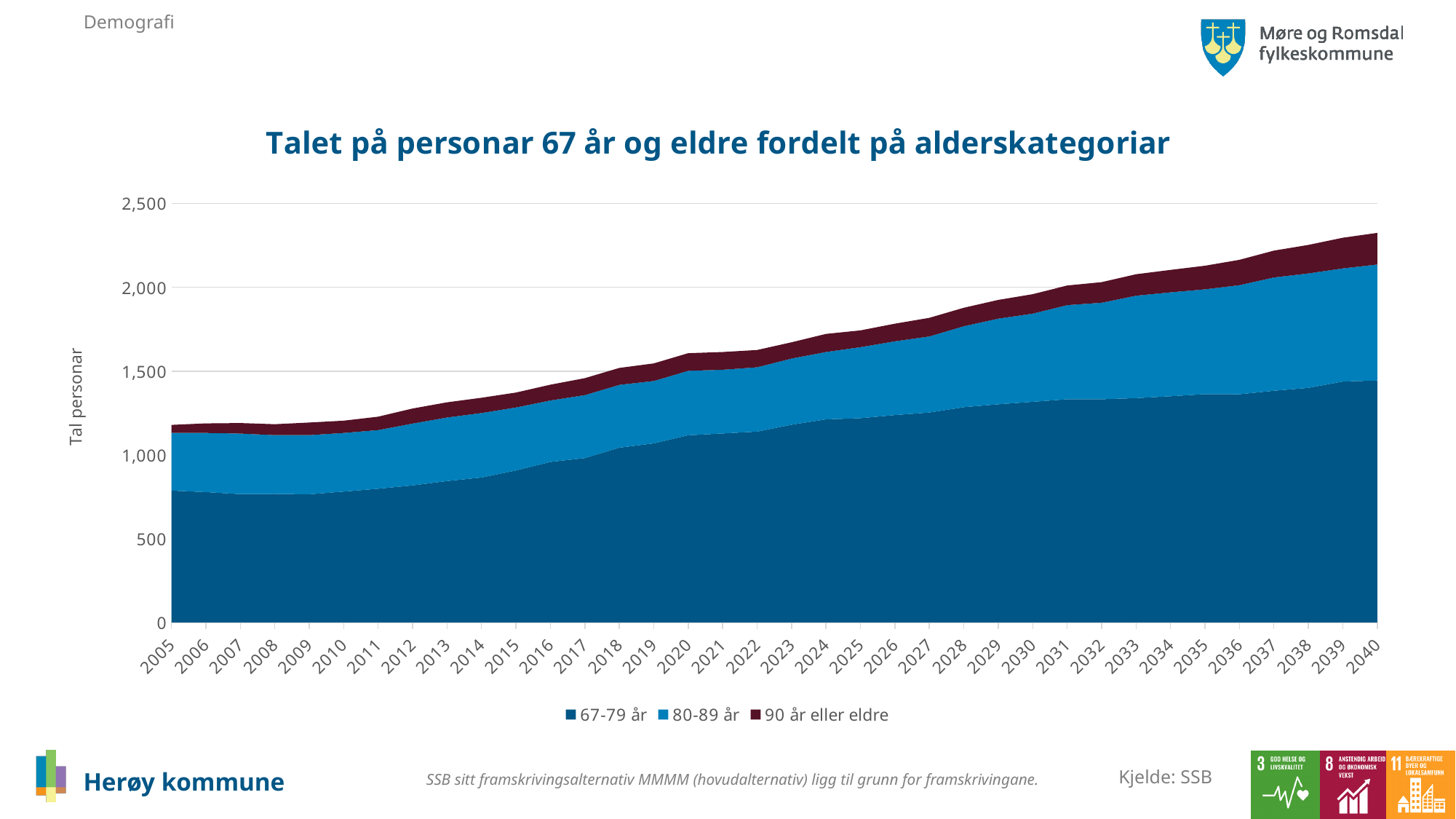
Which age group has the largest number of persons in 2040? 67-79 år Does the total number of persons 67 years and older rise or fall from 2005 to 2040? Rise Is the total of all three age groups in 2005 greater or less than 1,500? less What is the label of the y axis? Tal personar How many series does the legend list? 3 What kind of chart is shown on the slide? Stacked area chart Is the value for 67-79 år in 2005 greater or less than 1,000? less What is the title of the chart? Talet på personar 67 år og eldre fordelt på alderskategoriar Which age group has the smallest number of persons in 2005? 90 år eller eldre How many years are shown along the x axis? 36 Is the value for 67-79 år in 2040 greater or less than 1,000? greater